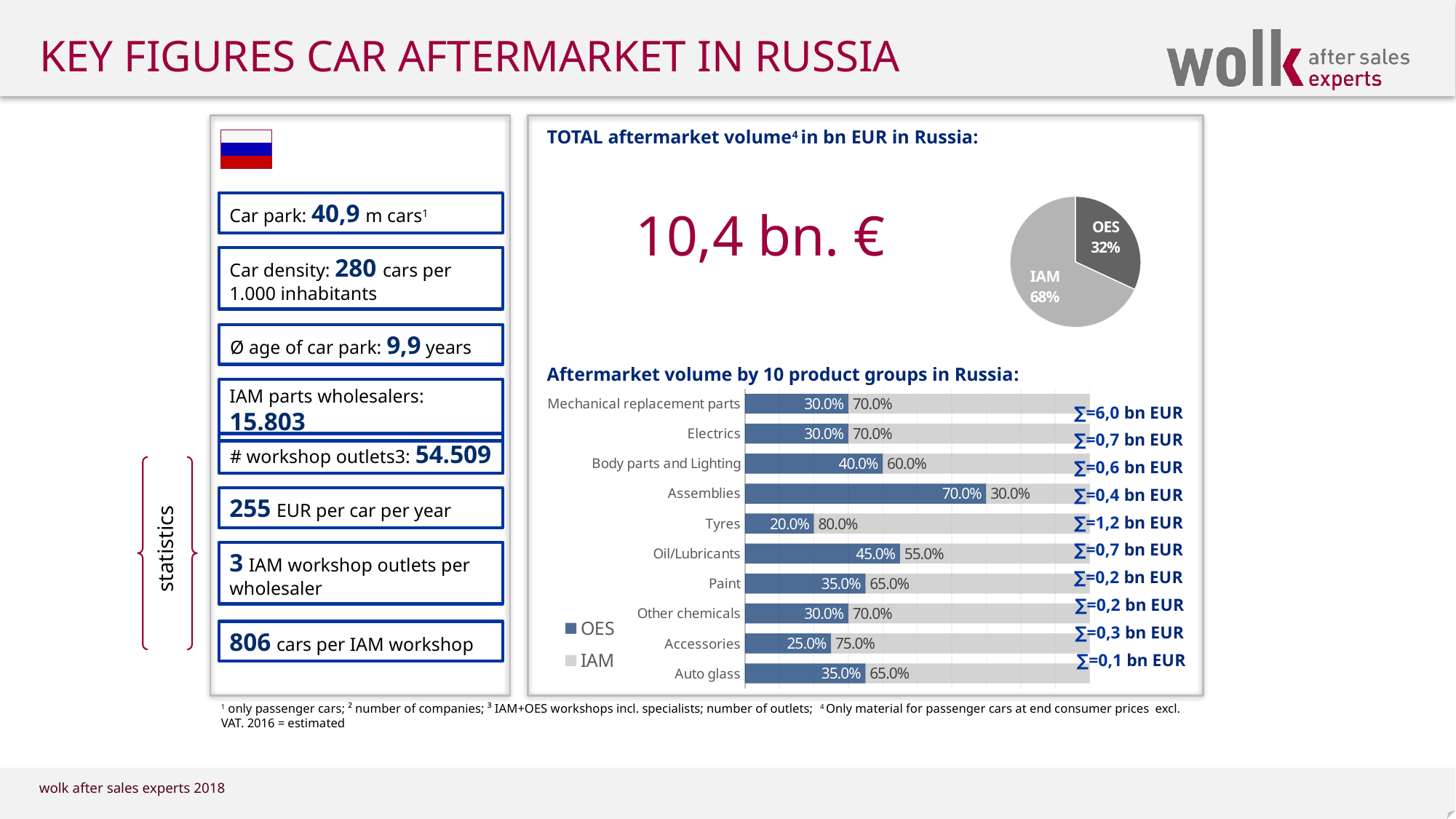
In the bar chart of aftermarket volume by product groups, which product group has the highest OES share? Assemblies In the bar chart of aftermarket volume by product groups, which product group has the lowest OES share? Tyres In the pie chart, what share of the total aftermarket volume is IAM? 68% In the bar chart of aftermarket volume by product groups, how many series does the legend list? 2 In the bar chart of aftermarket volume by product groups, what is the difference between the IAM share and the OES share for Oil/Lubricants? 10.0% In the pie chart, what share of the total aftermarket volume is OES? 32% In the bar chart of aftermarket volume by product groups, how many product groups are shown? 10 In the pie chart, which segment is larger, OES or IAM? IAM In the bar chart of aftermarket volume by product groups, what is the total volume in bn EUR for Mechanical replacement parts? 6,0 bn EUR In the bar chart of aftermarket volume by product groups, what is the OES share for Assemblies? 70.0% What type of chart is used to show aftermarket volume by 10 product groups? Stacked bar chart In the bar chart of aftermarket volume by product groups, what is the IAM share for Tyres? 80.0%